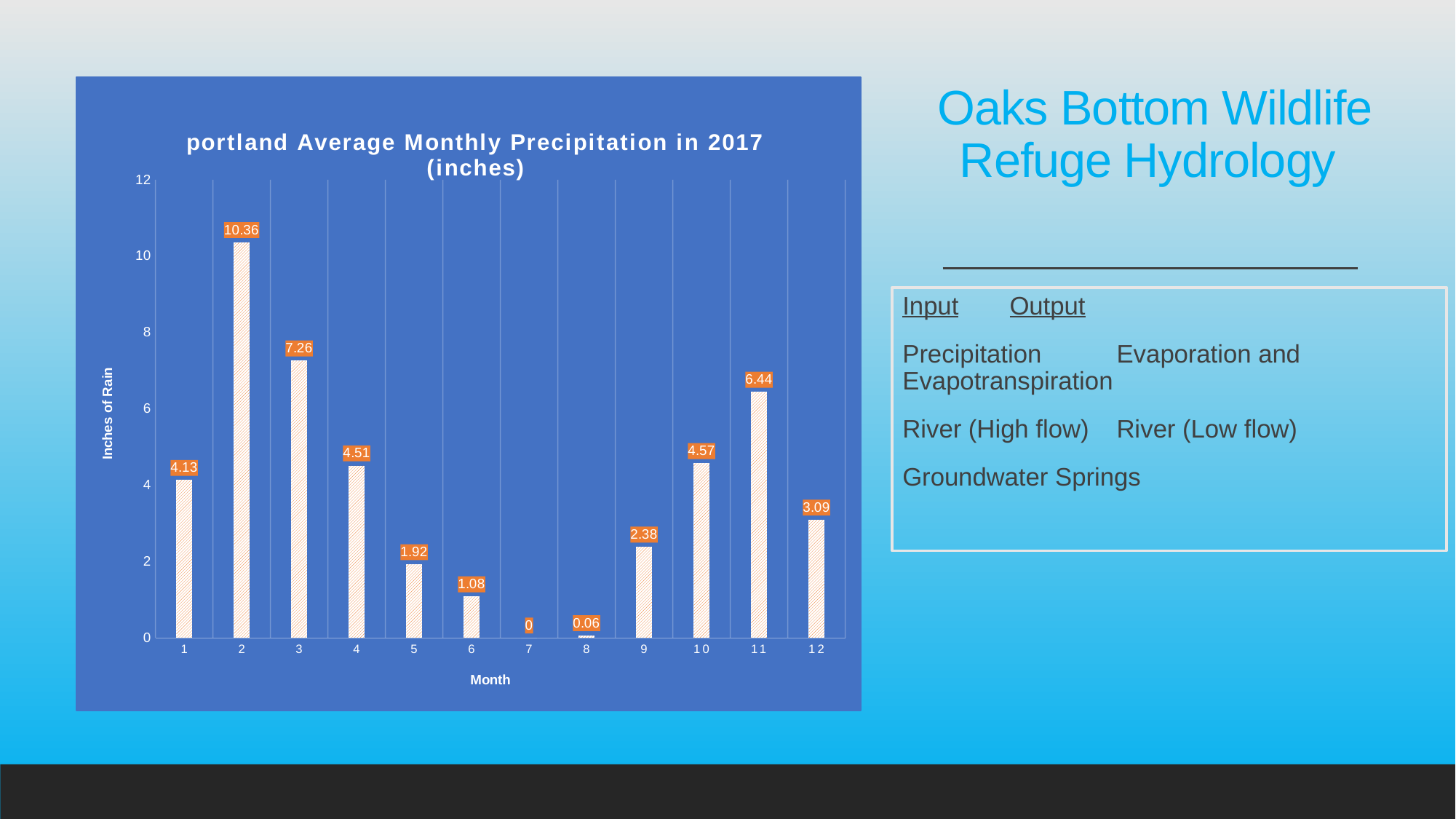
What is the label of the y axis? Inches of Rain What is the precipitation value for month 2? 10.36 How many months are plotted on the chart? 12 What is the title of the chart? portland Average Monthly Precipitation in 2017 (inches) What is the precipitation value for month 11? 6.44 Do the precipitation values rise or fall from month 2 to month 7? fall Which month has a larger precipitation value, month 4 or month 10? 10 What kind of chart is shown on the slide? bar chart Which month has the lowest precipitation? 7 What is the difference between the precipitation values for month 2 and month 3? 3.10 Which month has the highest precipitation? 2 What is the precipitation value for month 8? 0.06